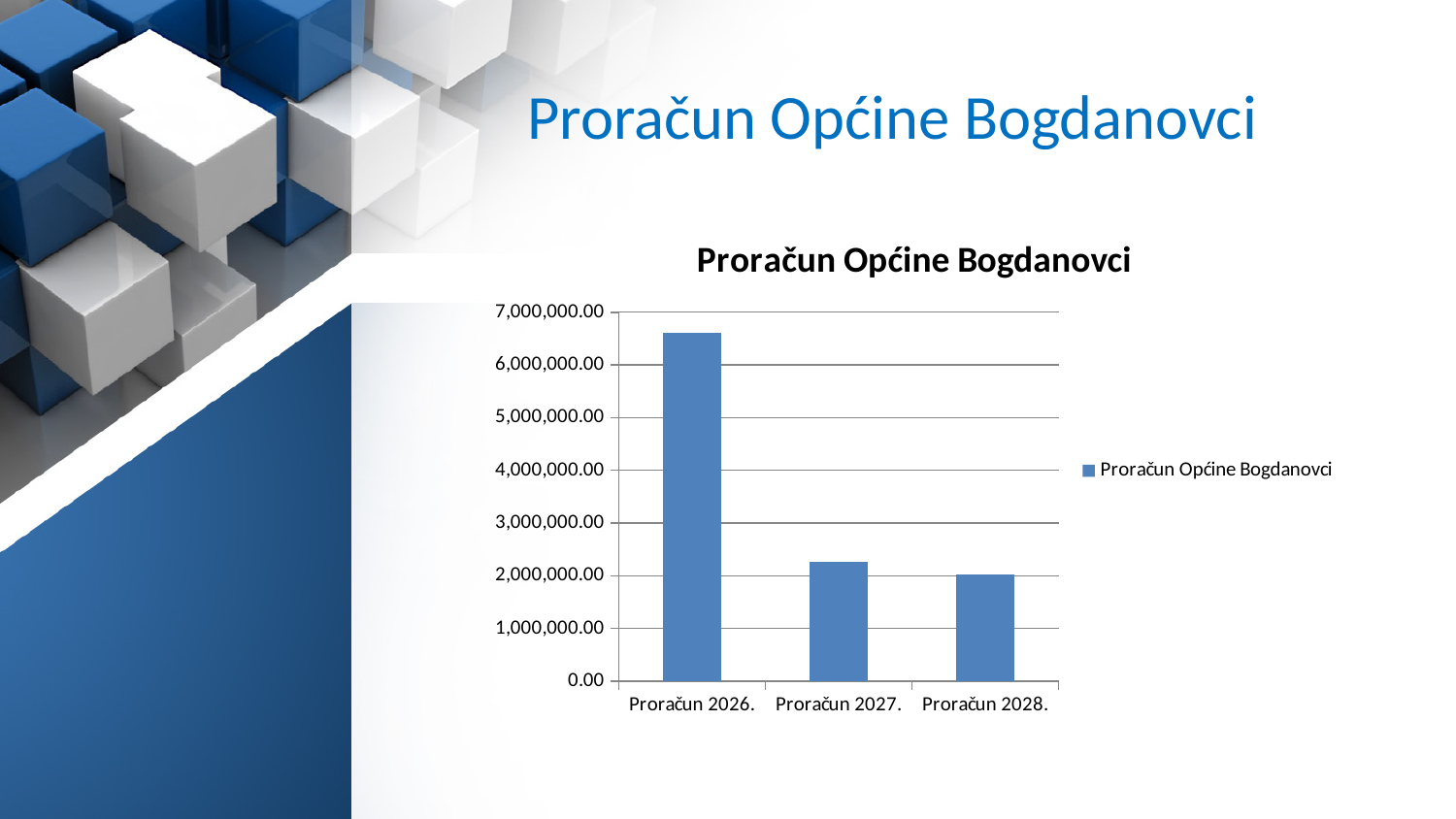
What is the name of the series listed in the legend? Proračun Općine Bogdanovci Which category has the lowest value in the chart? Proračun 2028. What is the title of the chart? Proračun Općine Bogdanovci Is the value for Proračun 2027. greater or less than 2,000,000.00? greater Which is larger, the value for Proračun 2026. or the value for Proračun 2027.? Proračun 2026. Is the value for Proračun 2026. greater or less than 7,000,000.00? less How many categories are shown on the x axis of the chart? 3 How many series does the chart legend list? 1 Is the value for Proračun 2026. greater or less than 6,000,000.00? greater Which category has the highest value in the chart? Proračun 2026. What kind of chart is shown on the slide? bar chart